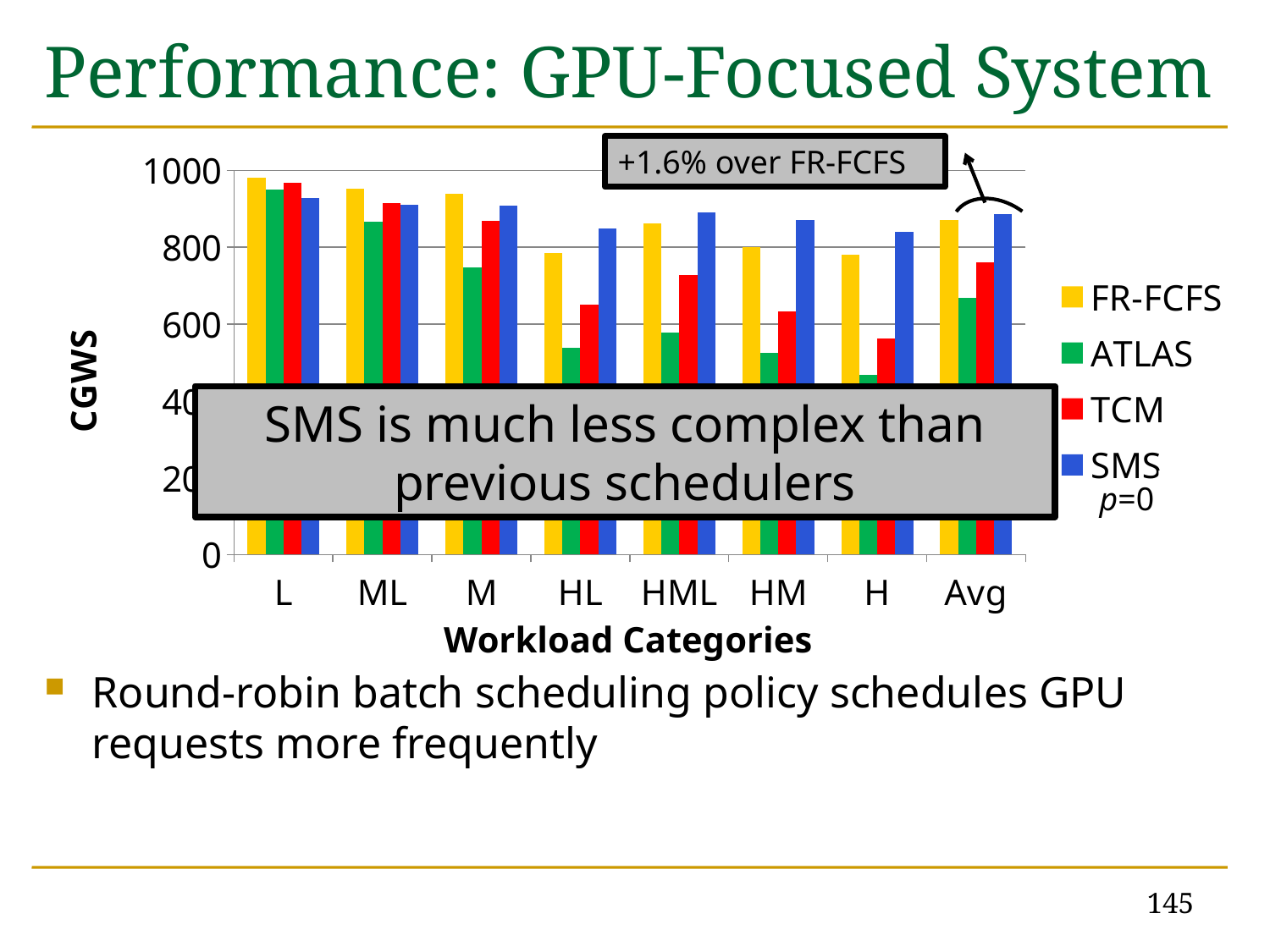
How many workload categories are shown on the x axis? 8 For the HL category, which is larger, FR-FCFS or ATLAS? FR-FCFS Is the ATLAS value for M greater or less than 800? less What kind of chart is shown on the slide? bar chart What is the label of the y axis? CGWS For the HL category, which series has the lowest value? ATLAS Is the SMS value for HML greater or less than 800? greater Is the TCM value for HL greater or less than 600? greater Which series is shown in blue in the legend? SMS Across the workload categories, which category has the highest FR-FCFS value? L How many series does the legend list? 4